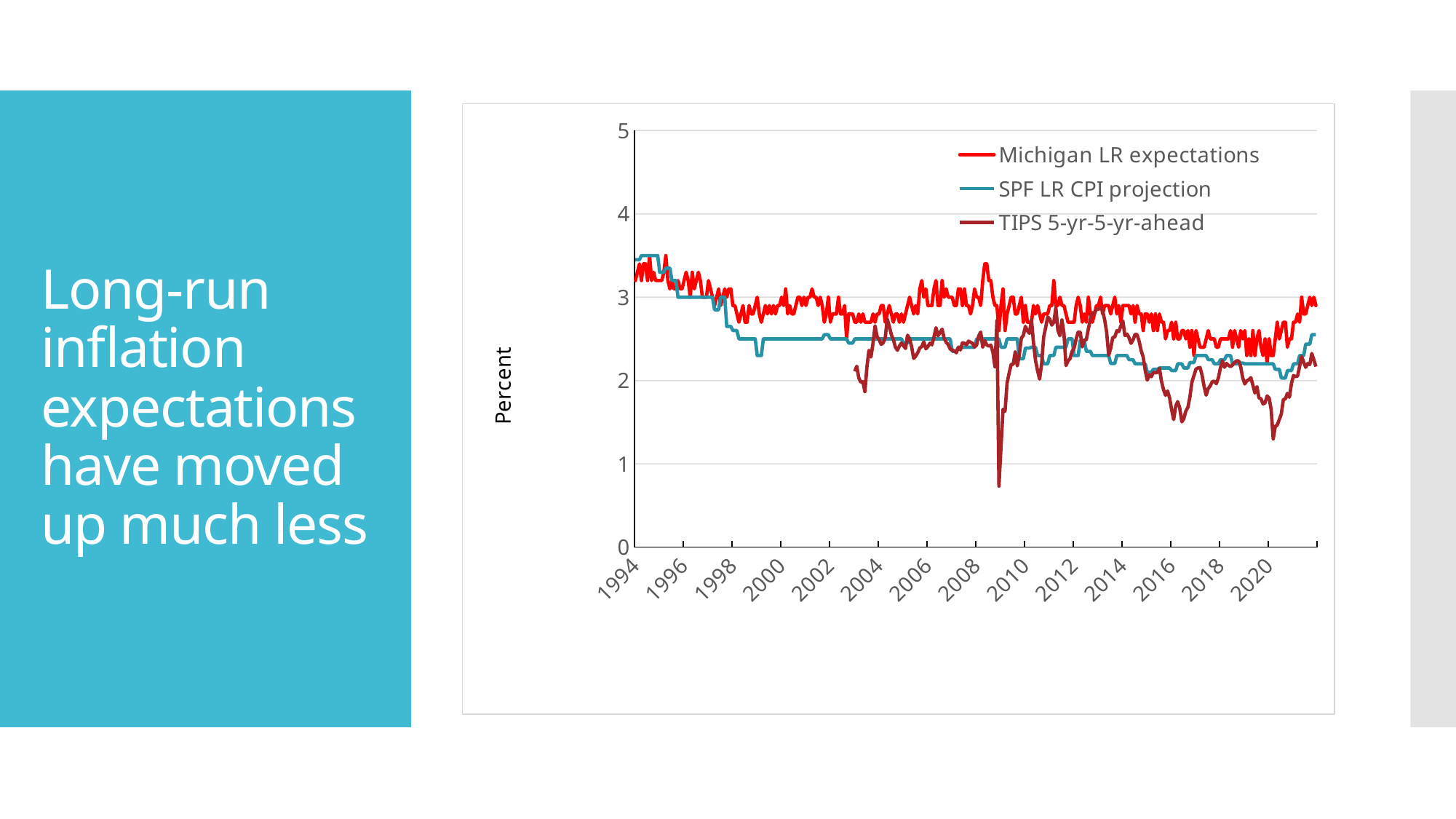
Is the lowest value of the TIPS 5-yr-5-yr-ahead series, around 2009, greater or less than 1? less Which series is drawn in bright red in the chart? Michigan LR expectations What is the label on the vertical axis of the chart? Percent Around 2016, which series is higher: Michigan LR expectations or TIPS 5-yr-5-yr-ahead? Michigan LR expectations Is the value of Michigan LR expectations around 2020 greater or less than 2? greater Does the SPF LR CPI projection generally rise or fall from 1994 to 2020? fall Around 2009, which series is lower: TIPS 5-yr-5-yr-ahead or SPF LR CPI projection? TIPS 5-yr-5-yr-ahead How many series does the legend list? 3 Which series reaches the lowest value anywhere on the chart? TIPS 5-yr-5-yr-ahead Is the value of the SPF LR CPI projection around 2010 greater or less than 3? less What kind of chart is shown on the slide? line chart